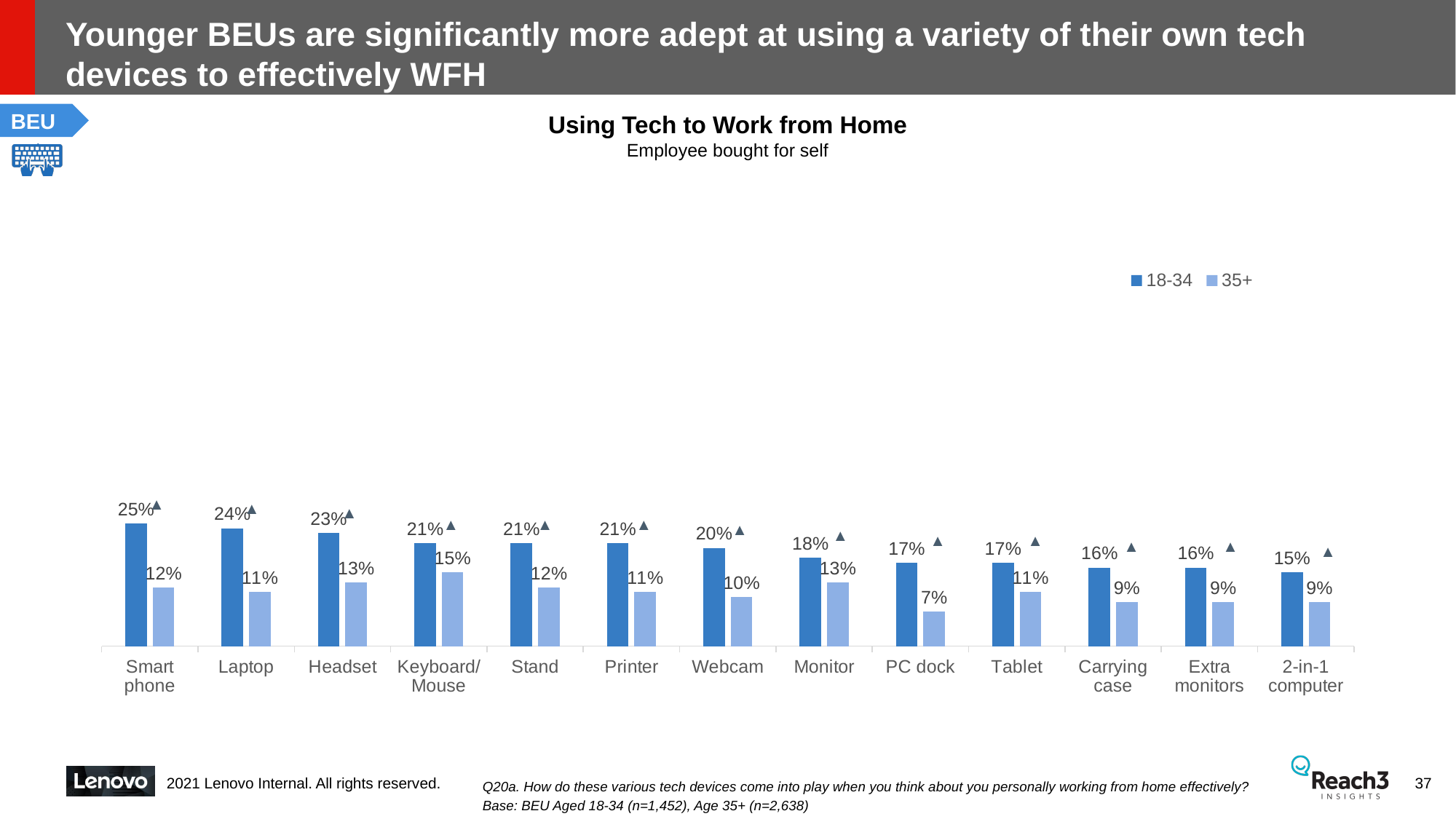
Which is larger for Monitor: the 18-34 value or the 35+ value? 18-34 What is the difference between the 18-34 and 35+ values for Webcam? 10% What is the value for the 35+ series for PC dock? 7% How many device categories are shown on the x axis? 13 What is the difference between the 18-34 and 35+ values for Laptop? 13% What is the value for the 18-34 series for Smart phone? 25% How many series does the legend list? 2 What is the value for the 35+ series for Keyboard/Mouse? 15% Which category has the lowest value for the 35+ series? PC dock What is the title of the chart? Using Tech to Work from Home What kind of chart is shown on the slide? Bar chart Which category has the highest value for the 18-34 series? Smart phone